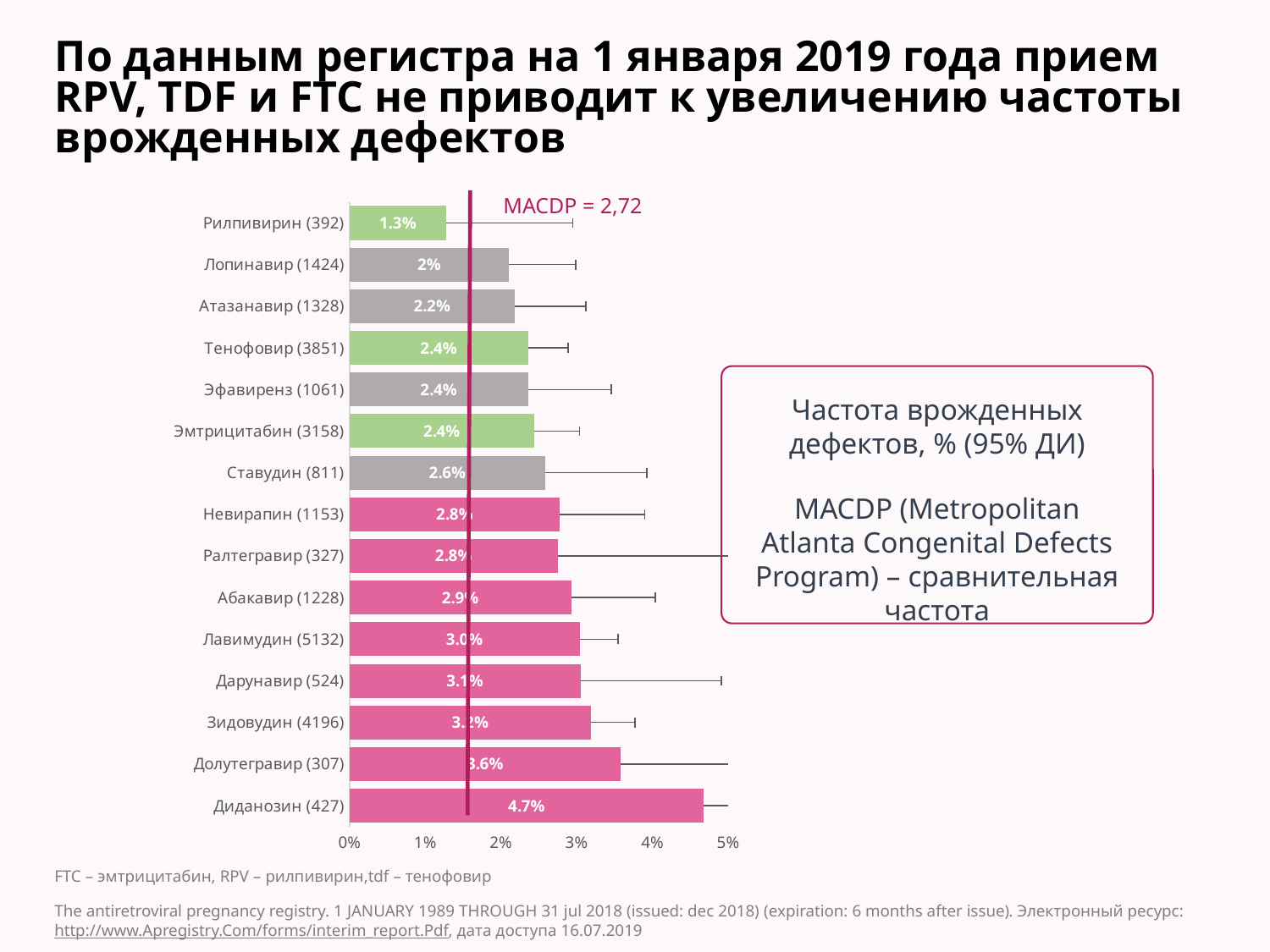
What is the difference between the values for Диданозин (427) and Рилпивирин (392)? 3.4% Which drug has the highest birth defect rate on the chart? Диданозин (427) What is the birth defect rate shown for Рилпивирин (392)? 1.3% What kind of chart is shown on the slide? Bar chart What is the MACDP comparison value marked by the vertical line on the chart? 2,72 Which drug has the lowest birth defect rate on the chart? Рилпивирин (392) Which has a higher value, Долутегравир (307) or Зидовудин (4196)? Долутегравир (307) Is the value for Дарунавир (524) greater or less than 3%? greater What is the value shown for Ламивудин (5132)? 3.0% What is the value shown for Диданозин (427)? 4.7% How many drugs are listed on the chart? 15 What is the maximum value shown on the horizontal axis of the chart? 5%